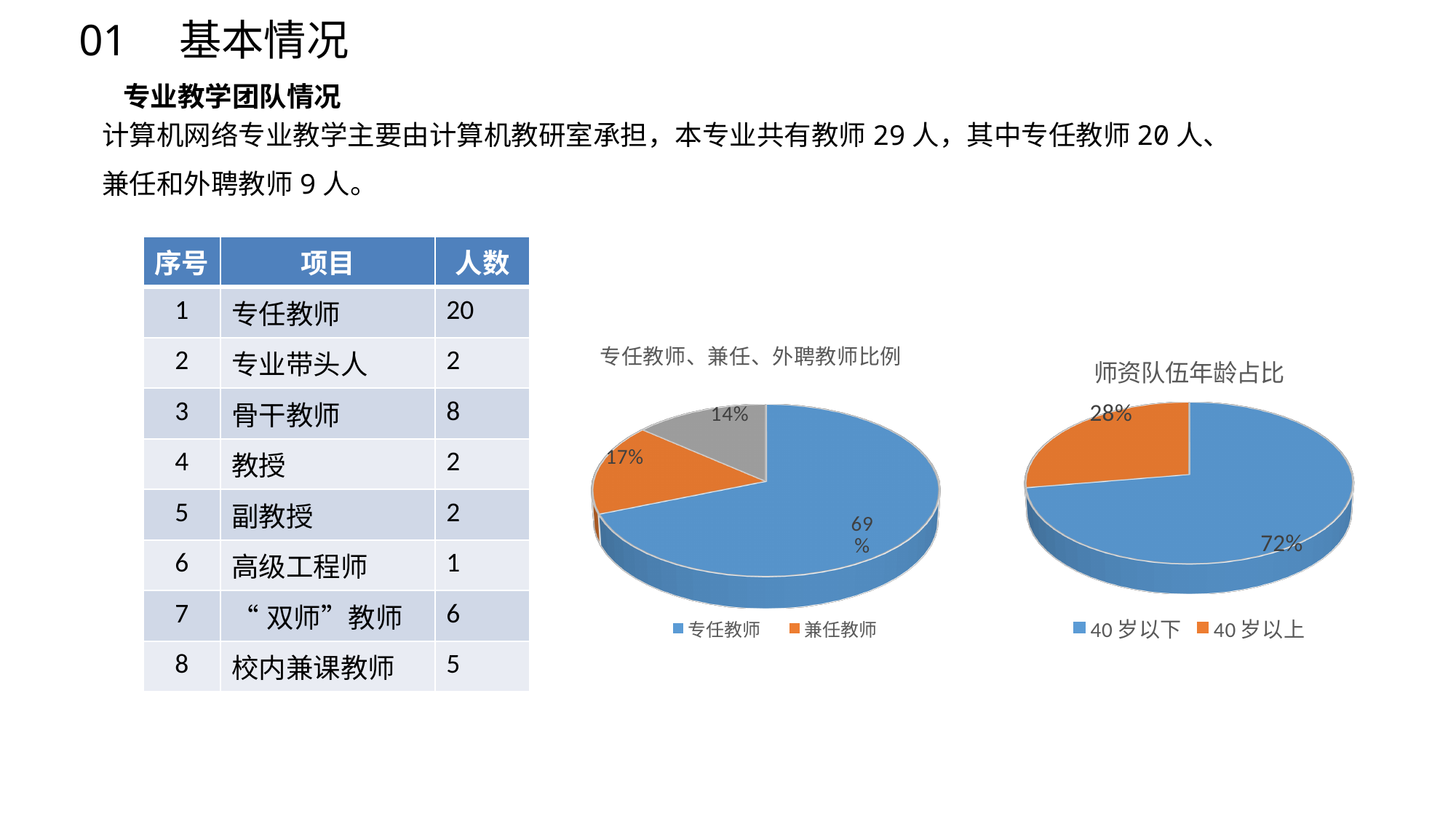
In the chart titled 专任教师、兼任、外聘教师比例, what share is shown for 兼任教师? 17% How many entries does the legend of the chart titled 师资队伍年龄占比 list? 2 In the chart titled 师资队伍年龄占比, what share is shown for 40 岁以下? 72% In the chart titled 专任教师、兼任、外聘教师比例, what share is shown for 专任教师? 69% In the chart titled 专任教师、兼任、外聘教师比例, which category has the largest slice? 专任教师 How many slices does the chart titled 专任教师、兼任、外聘教师比例 have? 3 In the chart titled 专任教师、兼任、外聘教师比例, what percentage is labelled on the grey slice? 14% In the chart titled 师资队伍年龄占比, what is the difference in percentage points between 40 岁以下 and 40 岁以上? 44 In the chart titled 师资队伍年龄占比, which category has the smallest slice? 40 岁以上 In the chart titled 专任教师、兼任、外聘教师比例, which is larger, the slice for 专任教师 or the slice for 兼任教师? 专任教师 What kind of chart is the one titled 师资队伍年龄占比? Pie chart In the chart titled 师资队伍年龄占比, what share is shown for 40 岁以上? 28%